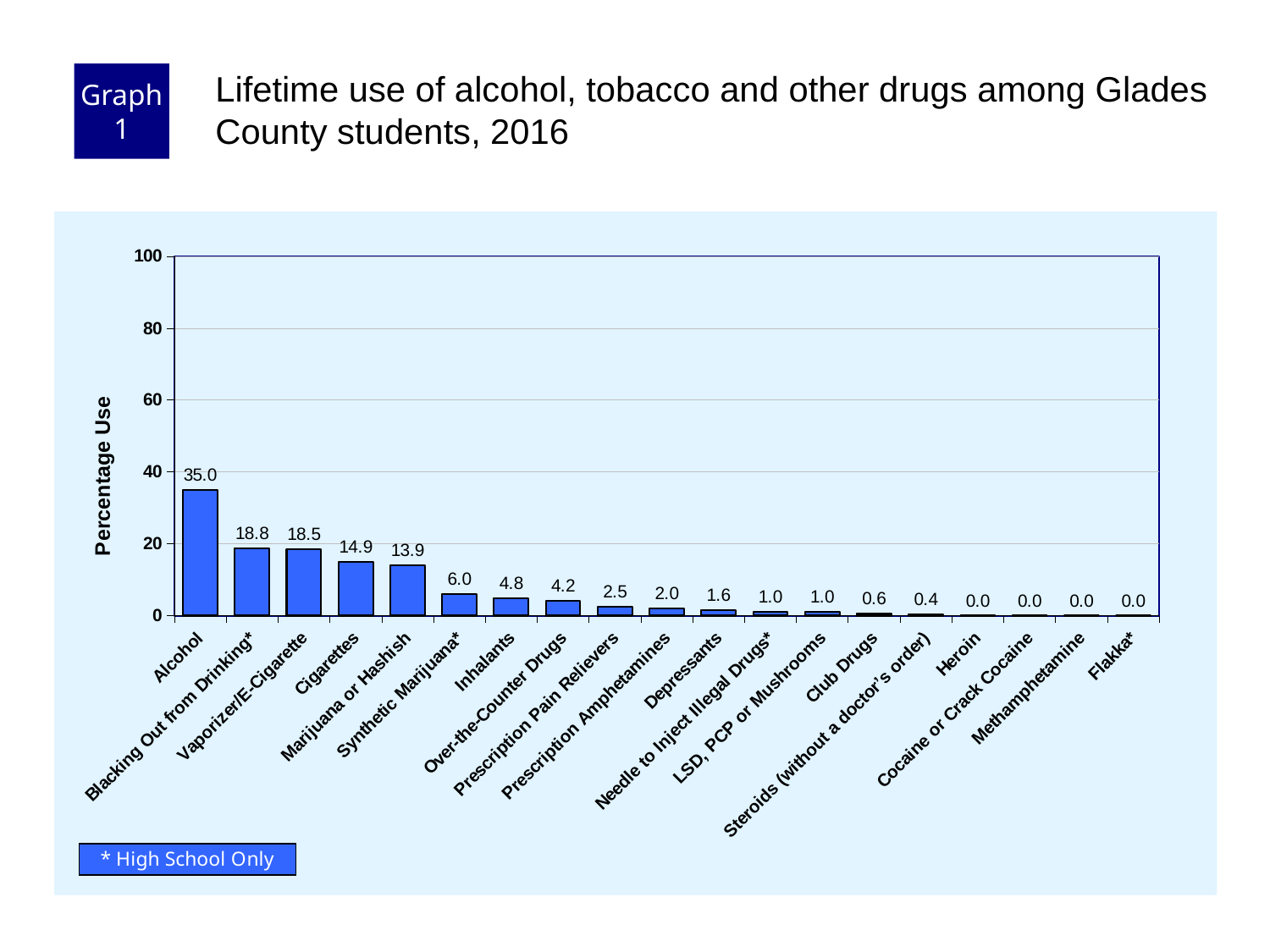
What is the percentage use for Synthetic Marijuana*? 6.0 Is the value for Alcohol greater or less than 40? less Which category has the highest percentage use? Alcohol What is the percentage use for Club Drugs? 0.6 What is the label of the y axis? Percentage Use What is the percentage use for Cigarettes? 14.9 How many categories are shown on the x axis? 19 What is the percentage use for Alcohol? 35.0 Which has a higher percentage use, Vaporizer/E-Cigarette or Cigarettes? Vaporizer/E-Cigarette What kind of chart is shown on the slide? Bar chart What is the difference in percentage use between Alcohol and Blacking Out from Drinking*? 16.2 What is the difference in percentage use between Marijuana or Hashish and Inhalants? 9.1